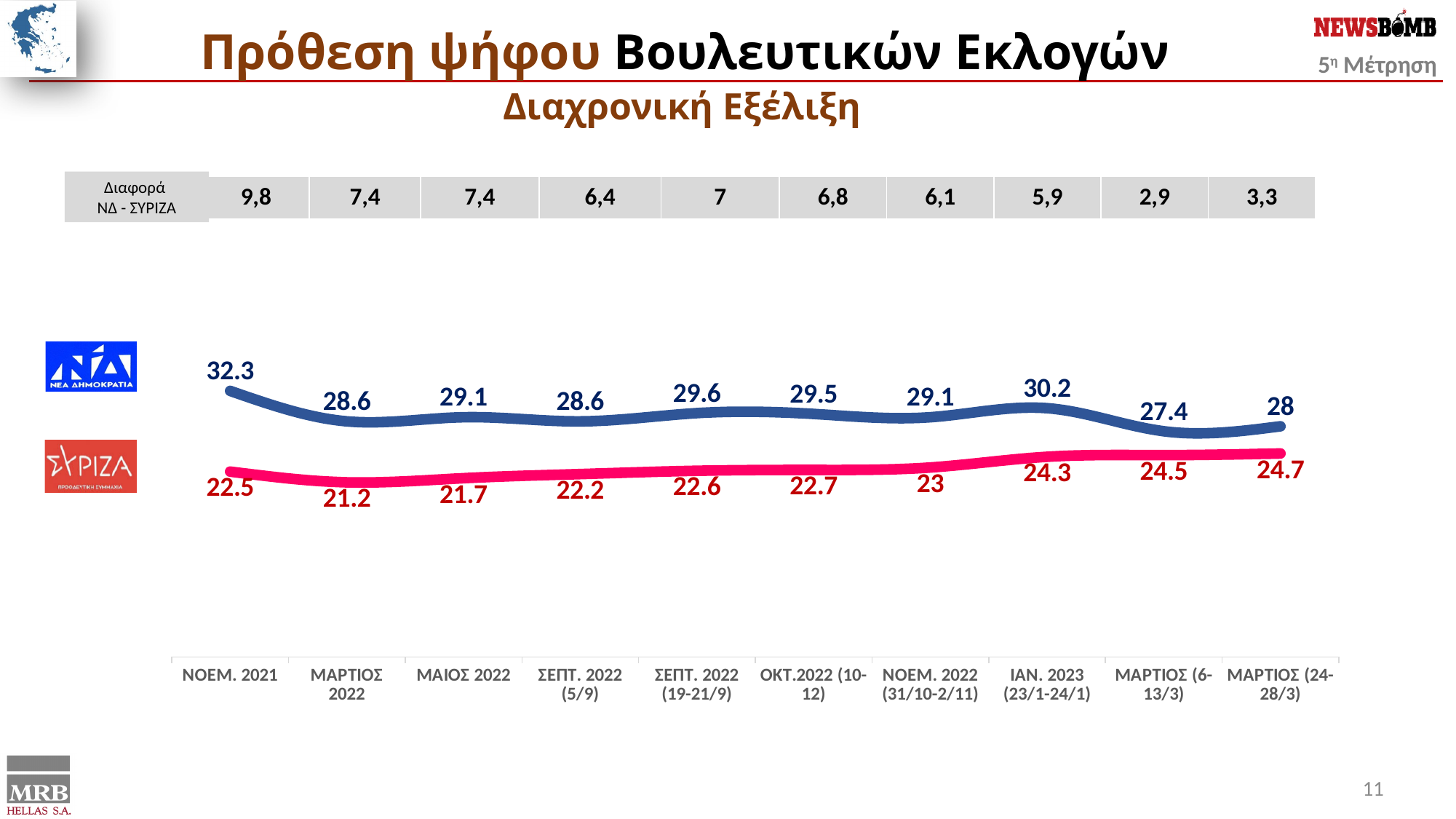
What colour is the line for ΝΔ (ΝΕΑ ΔΗΜΟΚΡΑΤΙΑ)? blue At which time point does ΣΥΡΙΖΑ have its lowest value? ΜΑΡΤΙΟΣ 2022 How many series are plotted in the chart? 2 Does the ΣΥΡΙΖΑ line rise or fall from ΜΑΡΤΙΟΣ 2022 to ΜΑΡΤΙΟΣ (24-28/3)? rise How many time points are shown along the x axis of the chart? 10 What is the value for ΝΔ (ΝΕΑ ΔΗΜΟΚΡΑΤΙΑ) at ΙΑΝ. 2023 (23/1-24/1)? 30.2 What kind of chart is shown on the slide? line chart At which time point does ΝΔ reach its highest value? ΝΟΕΜ. 2021 At which time point does ΝΔ have its lowest value? ΜΑΡΤΙΟΣ (6-13/3) What is the difference between the ΝΔ value at ΝΟΕΜ. 2021 and at ΜΑΡΤΙΟΣ 2022? 3.7 What is the value for ΣΥΡΙΖΑ at ΟΚΤ.2022 (10-12)? 22.7 Which is larger for ΝΔ: the value at ΙΑΝ. 2023 (23/1-24/1) or at ΜΑΡΤΙΟΣ (6-13/3)? ΙΑΝ. 2023 (23/1-24/1)